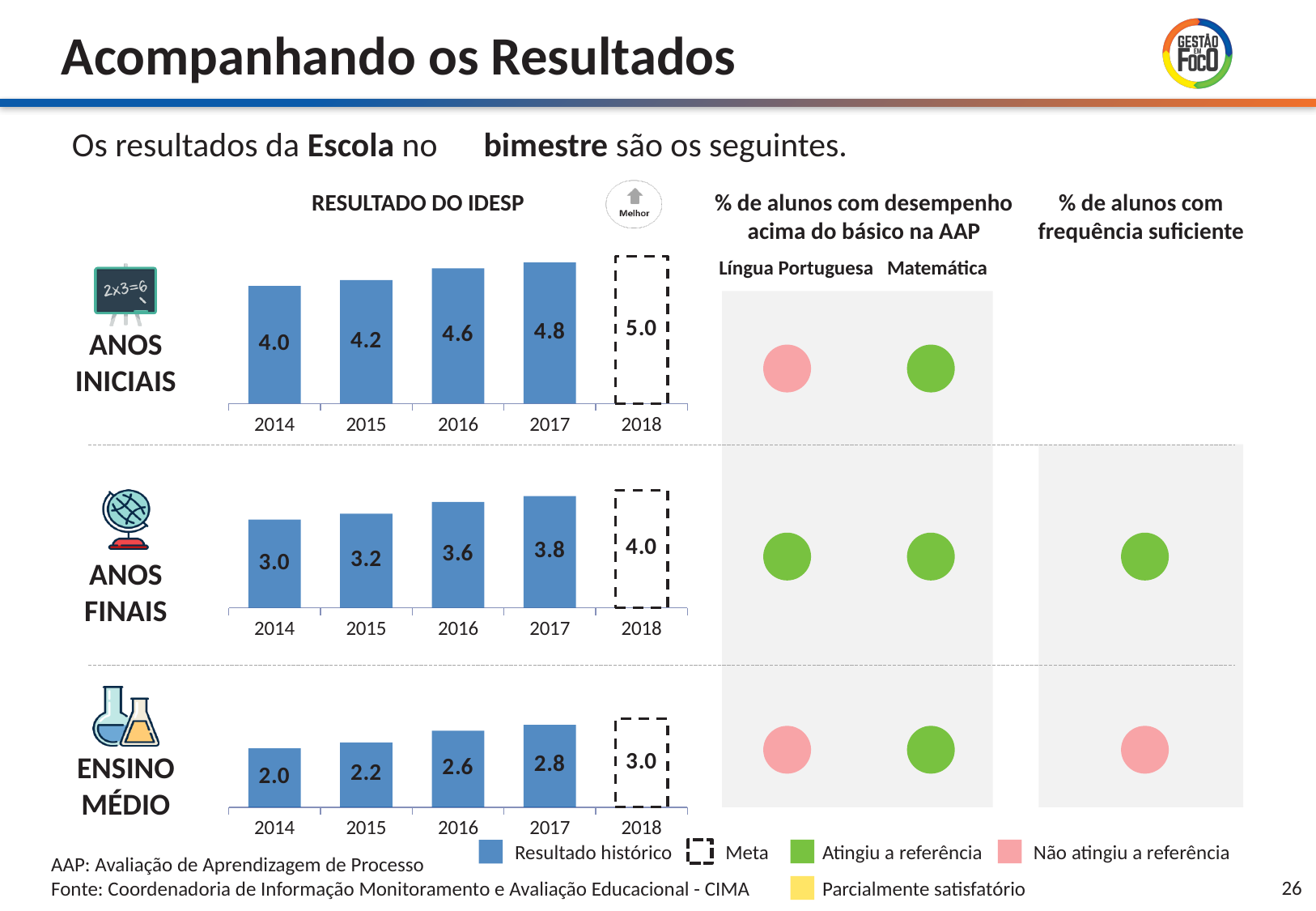
In the ANOS INICIAIS chart, which year has the highest historical result (excluding the 2018 meta)? 2017 In the ANOS INICIAIS chart, what is the difference between the 2018 meta and the 2017 result? 0.2 In the ANOS INICIAIS chart, do the IDESP results rise or fall from 2014 to 2017? Rise How many years are shown on the x axis of the ANOS FINAIS chart? 5 In the ENSINO MÉDIO chart, which year has the lowest IDESP result? 2014 What type of chart is used to show the RESULTADO DO IDESP for each school level? Bar chart In the ANOS INICIAIS chart, what is the IDESP result for 2016? 4.6 In the ENSINO MÉDIO chart, which is larger: the 2015 result or the 2016 result? 2016 In the IDESP charts, what does the dashed outlined bar represent according to the legend? Meta In the ANOS FINAIS chart, what is the difference between the 2017 result and the 2014 result? 0.8 In the ANOS FINAIS chart, what is the IDESP result for 2014? 3.0 In the ENSINO MÉDIO chart, what is the 2018 meta (target) value? 3.0